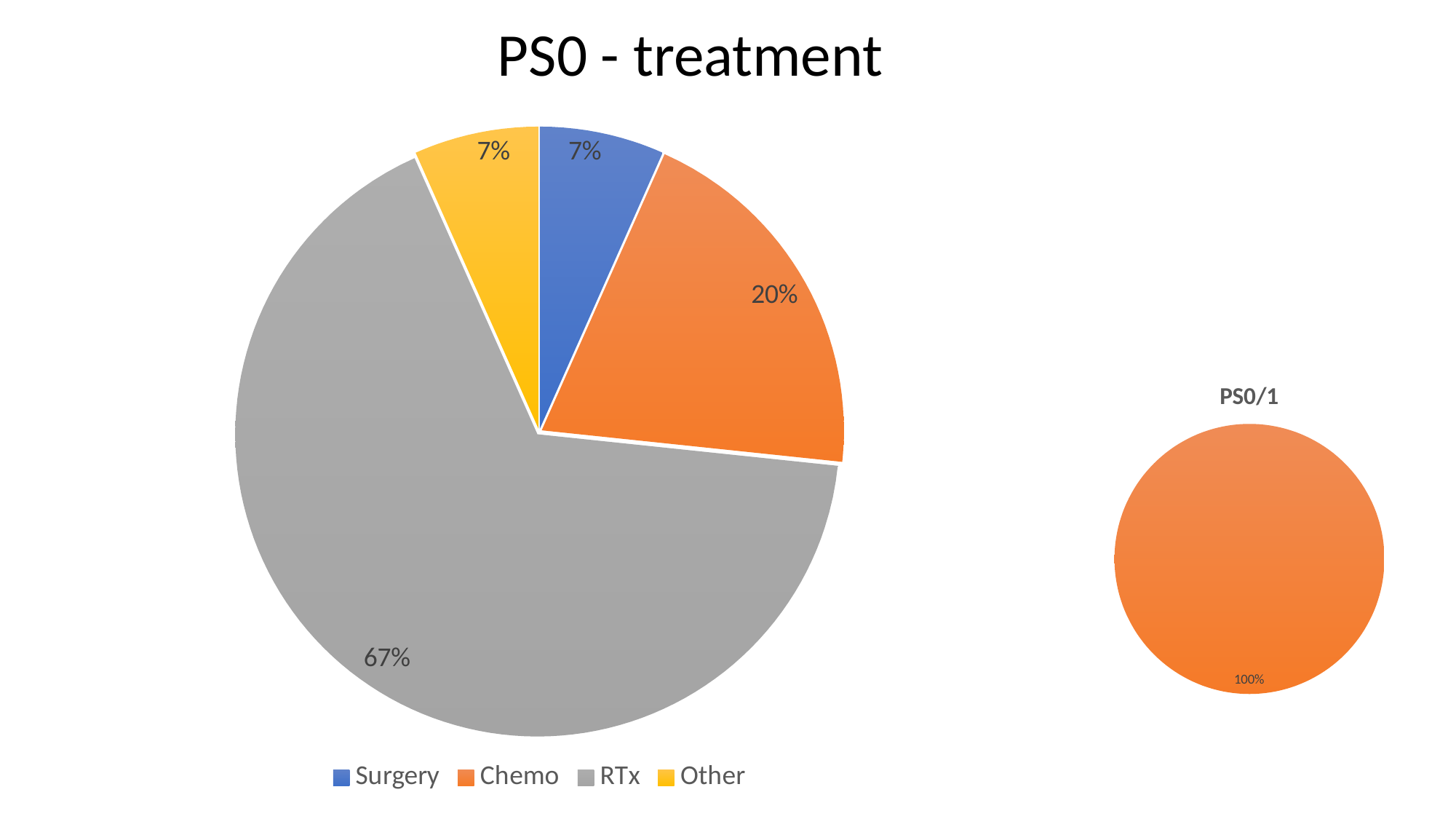
In the 'PS0 - treatment' chart, what is the difference in percentage points between RTx and Chemo? 47 In the 'PS0 - treatment' chart, which category has the largest slice? RTx In the 'PS0/1' chart on the right, what percentage is shown on the single slice? 100% What is the title of the chart on the right side of the slide? PS0/1 In the 'PS0 - treatment' chart, what share does Surgery have? 7% In the 'PS0 - treatment' chart, what is the combined share of Surgery and Other? 14% In the 'PS0 - treatment' chart, how many categories does the legend list? 4 In the 'PS0 - treatment' chart, what share does RTx have? 67% In the 'PS0 - treatment' chart, what share does Chemo have? 20% In the 'PS0 - treatment' chart, what colour is the RTx slice? Grey In the 'PS0 - treatment' chart, which is larger, Chemo or Other? Chemo What kind of chart is the 'PS0 - treatment' chart? Pie chart